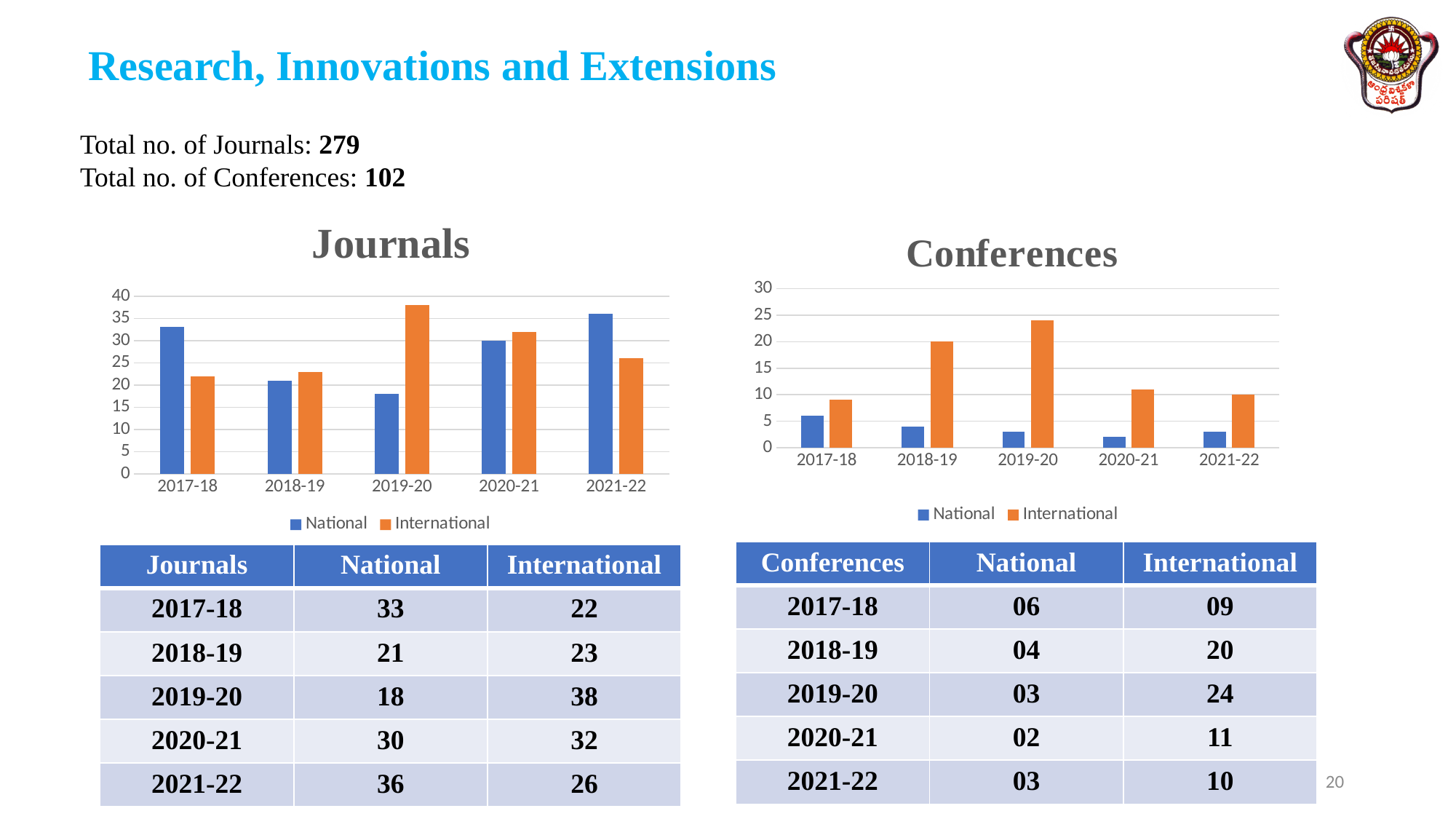
In the Conferences chart, what is the International value for 2019-20? 24 In the Conferences chart, is the International value for 2018-19 greater or less than 15? greater In the Journals chart, which is larger for 2017-18, National or International? National In the Journals chart, what is the International value for 2019-20? 38 In the Journals chart, what is the difference between the International and National values for 2019-20? 20 In the Journals chart, which year has the highest International value? 2019-20 In the Journals chart, which year has the lowest National value? 2019-20 In the Conferences chart, which year has the highest International value? 2019-20 In the Journals chart, what is the National value for 2021-22? 36 How many series does the legend of the Conferences chart list? 2 What type of chart is the Journals chart? Bar chart In the Conferences chart, which year has the lowest National value? 2020-21